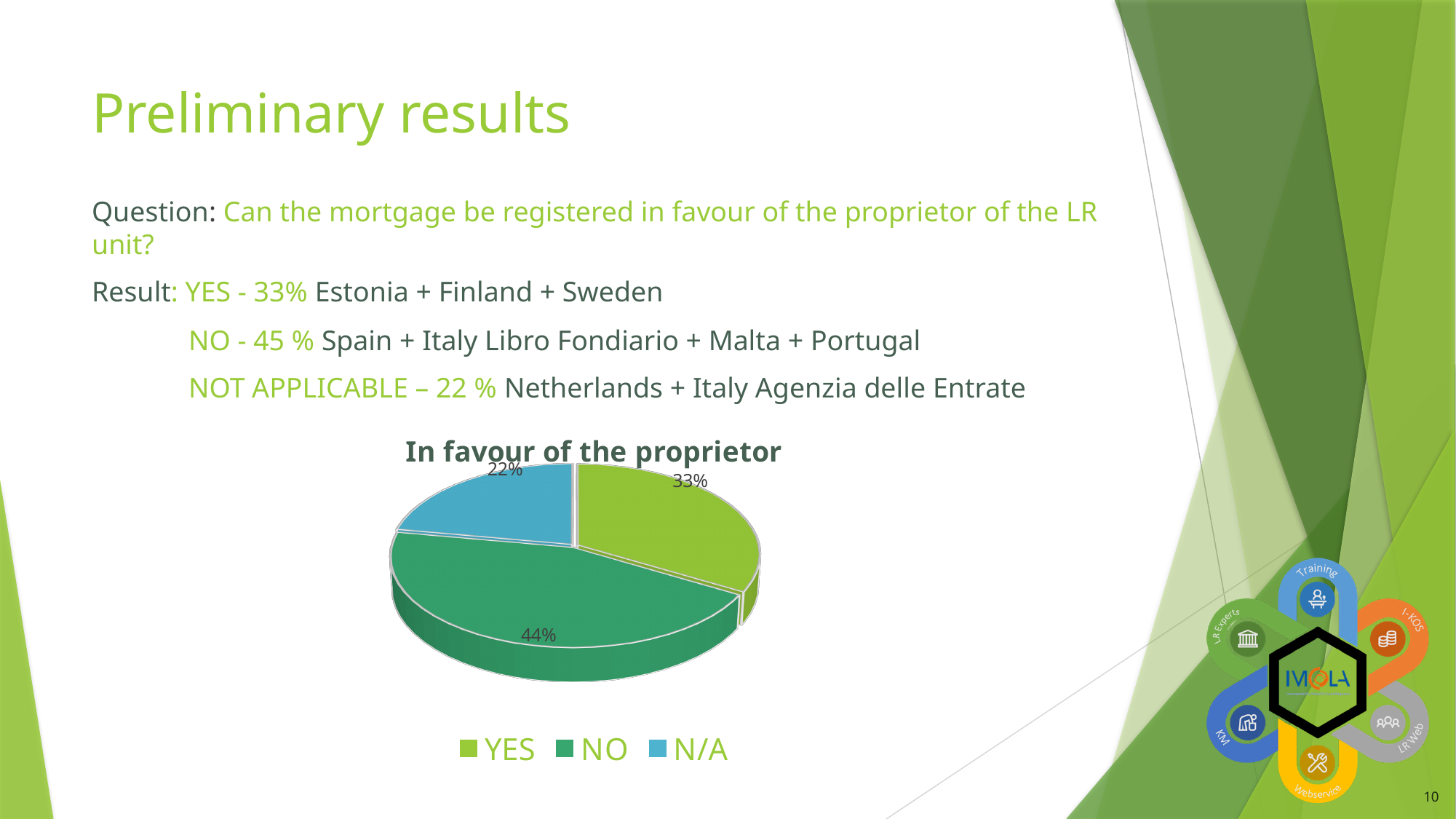
Which colour represents the N/A slice in the chart? light blue How many entries does the chart legend list? 3 What percentage does the NO slice show in the chart? 44% What percentage does the N/A slice show in the chart? 22% How many slices does the pie chart have? 3 What is the title of the chart? In favour of the proprietor Which category has the largest slice in the pie chart? NO What type of chart is shown on the slide? pie chart What is the difference in percentage points between the NO slice and the YES slice? 11 Which category has the smallest slice in the pie chart? N/A What percentage does the YES slice show in the chart? 33% Which slice is larger, YES or N/A? YES